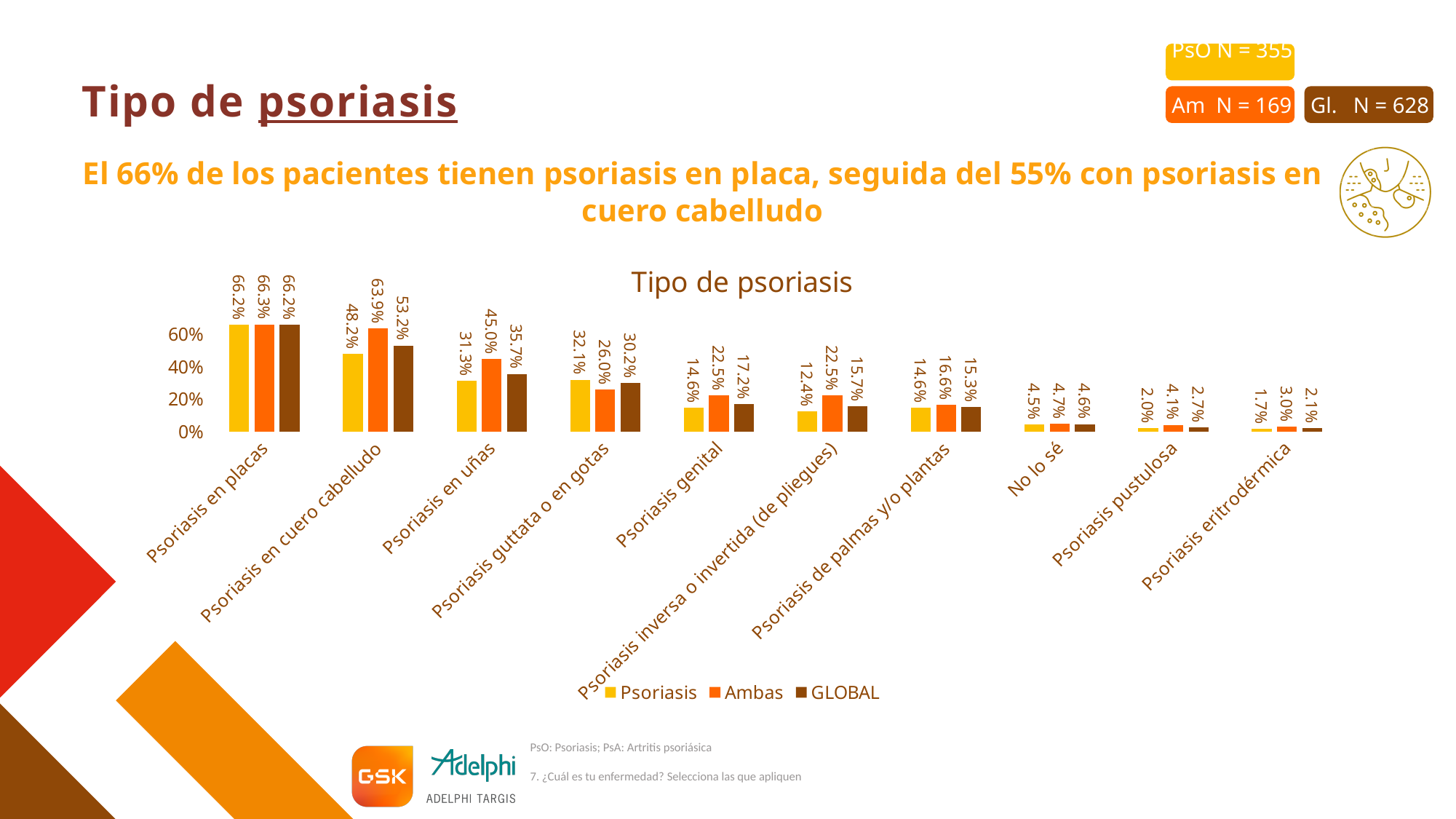
What is the GLOBAL value for Psoriasis en cuero cabelludo? 53.2% What is the Psoriasis series value for Psoriasis guttata o en gotas? 32.1% For Psoriasis guttata o en gotas, which is larger: the Psoriasis value or the Ambas value? Psoriasis Which category has the lowest Psoriasis series value? Psoriasis eritrodérmica What is the Ambas value for Psoriasis eritrodérmica? 3.0% How many categories are shown on the x axis? 10 What kind of chart is shown? Bar chart How many series does the legend list? 3 What is the difference between the Ambas and Psoriasis values for Psoriasis en cuero cabelludo? 15.7% Which category has the highest GLOBAL value? Psoriasis en placas What is the Ambas value for Psoriasis en uñas? 45.0% What is the title of the chart? Tipo de psoriasis